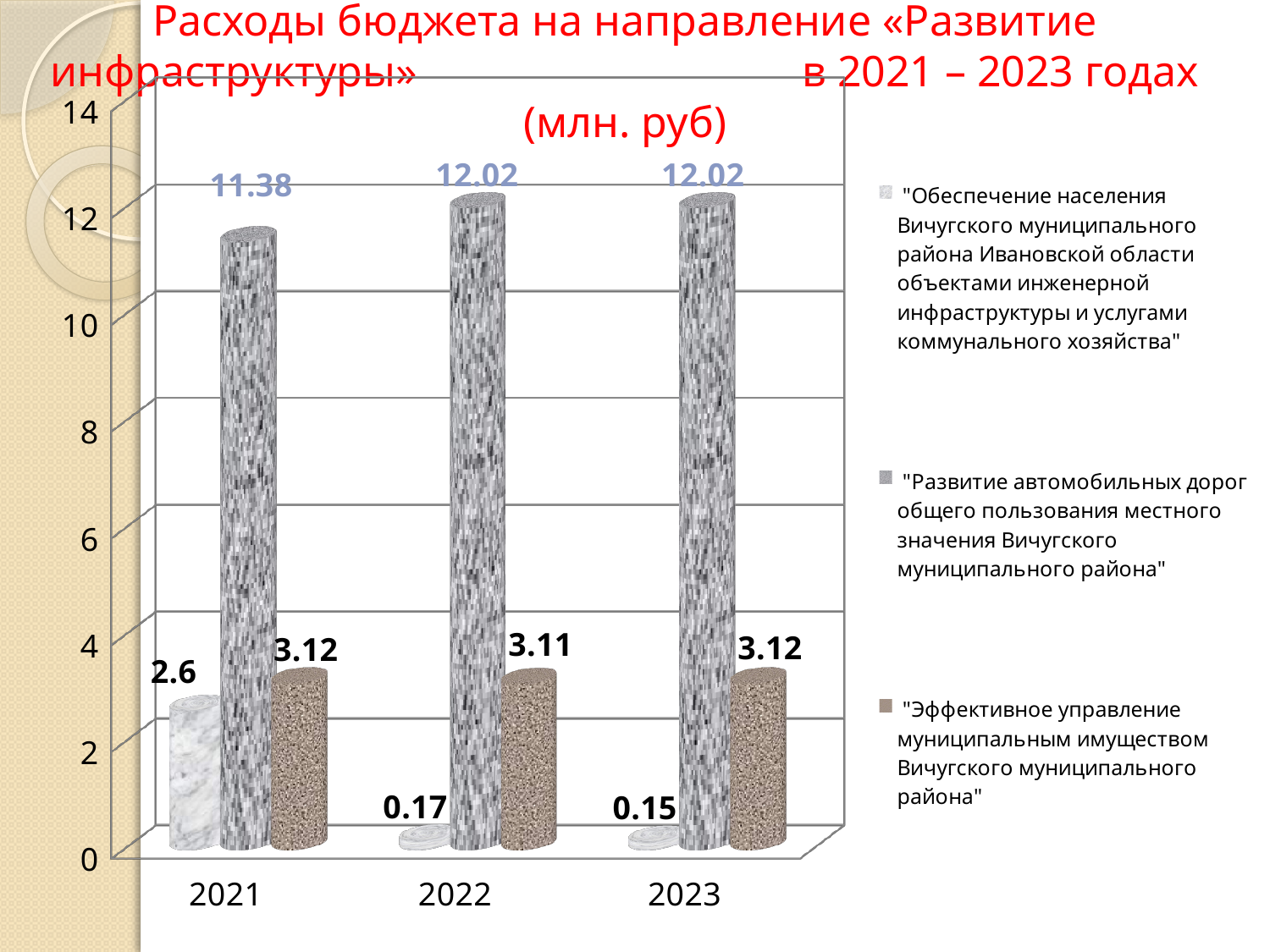
How many years are shown on the x axis? 3 What kind of chart is shown on the slide? Bar chart What is the value for "Обеспечение населения Вичугского муниципального района Ивановской области объектами инженерной инфраструктуры и услугами коммунального хозяйства" in 2022? 0.17 What is the value for "Эффективное управление муниципальным имуществом Вичугского муниципального района" in 2023? 3.12 What is the difference between the 2022 and 2021 values for "Развитие автомобильных дорог общего пользования местного значения Вичугского муниципального района"? 0.64 In which year is the value for "Обеспечение населения Вичугского муниципального района Ивановской области объектами инженерной инфраструктуры и услугами коммунального хозяйства" lowest? 2023 In which year is the value for "Развитие автомобильных дорог общего пользования местного значения Вичугского муниципального района" lowest? 2021 Which is larger in 2021: the value for "Обеспечение населения..." or the value for "Эффективное управление муниципальным имуществом..."? Эффективное управление муниципальным имуществом Вичугского муниципального района How many series does the legend list? 3 What is the value for "Обеспечение населения Вичугского муниципального района Ивановской области объектами инженерной инфраструктуры и услугами коммунального хозяйства" in 2021? 2.6 What is the value for "Развитие автомобильных дорог общего пользования местного значения Вичугского муниципального района" in 2021? 11.38 What is the difference between the 2021 values for "Эффективное управление муниципальным имуществом Вичугского муниципального района" and "Обеспечение населения Вичугского муниципального района Ивановской области объектами инженерной инфраструктуры и услугами коммунального хозяйства"? 0.52